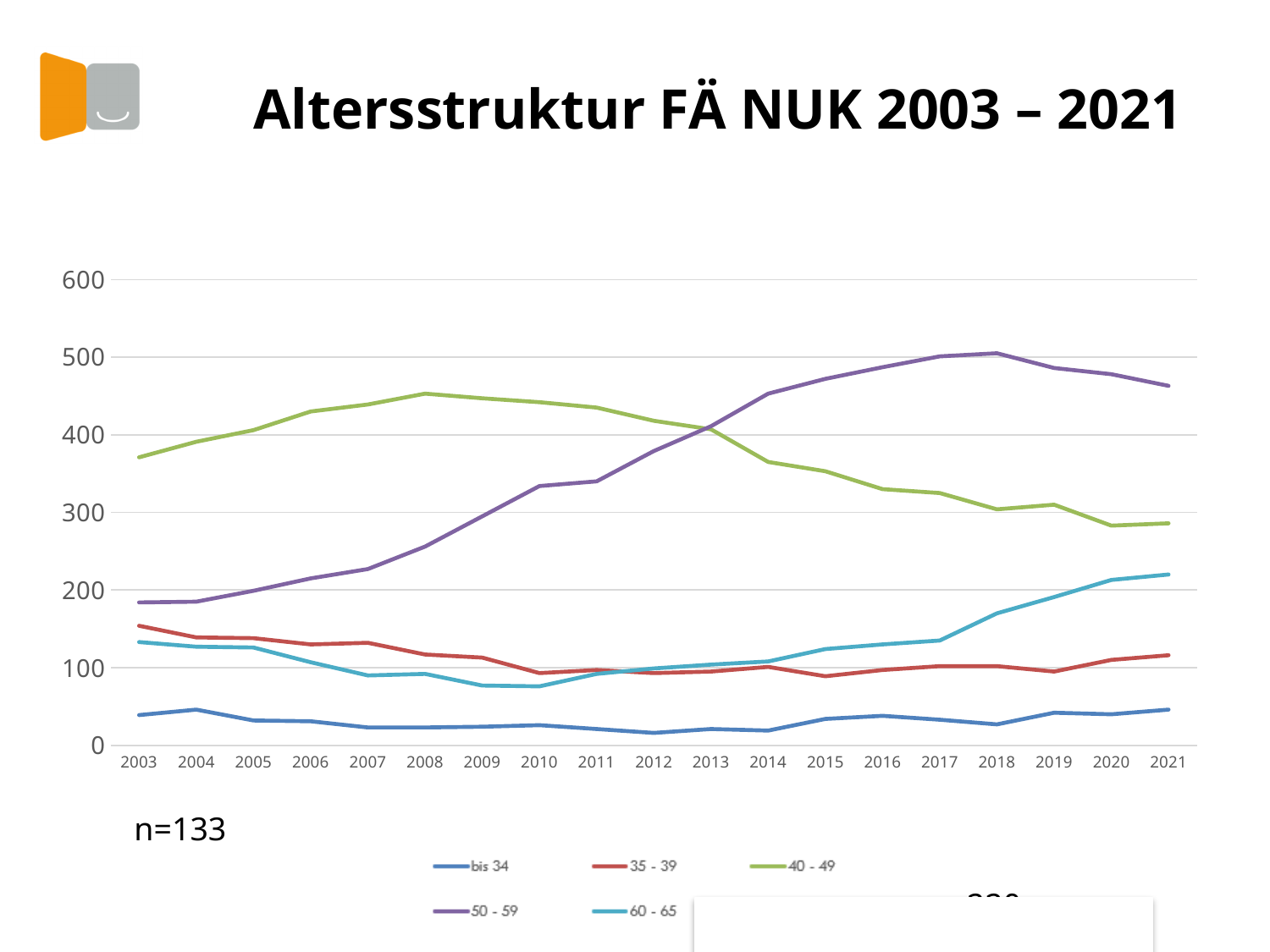
Does the 50 - 59 line rise or fall from 2003 to 2018? rise What kind of chart is shown on the slide? line chart In 2021, which is larger: the value for 60 - 65 or the value for 35 - 39? 60 - 65 How many years are shown on the x axis? 19 Is the value for the 60 - 65 group in 2021 greater or less than 200? greater Which age group has the lowest value in 2021? bis 34 Which age group has the highest value in 2003? 40 - 49 How many series does the legend list? 5 Is the value for the 50 - 59 group in 2003 greater or less than 200? less What is the title of the chart? Altersstruktur FÄ NUK 2003 – 2021 Which age group has the highest value in 2021? 50 - 59 Is the value for the 40 - 49 group in 2008 greater or less than 400? greater